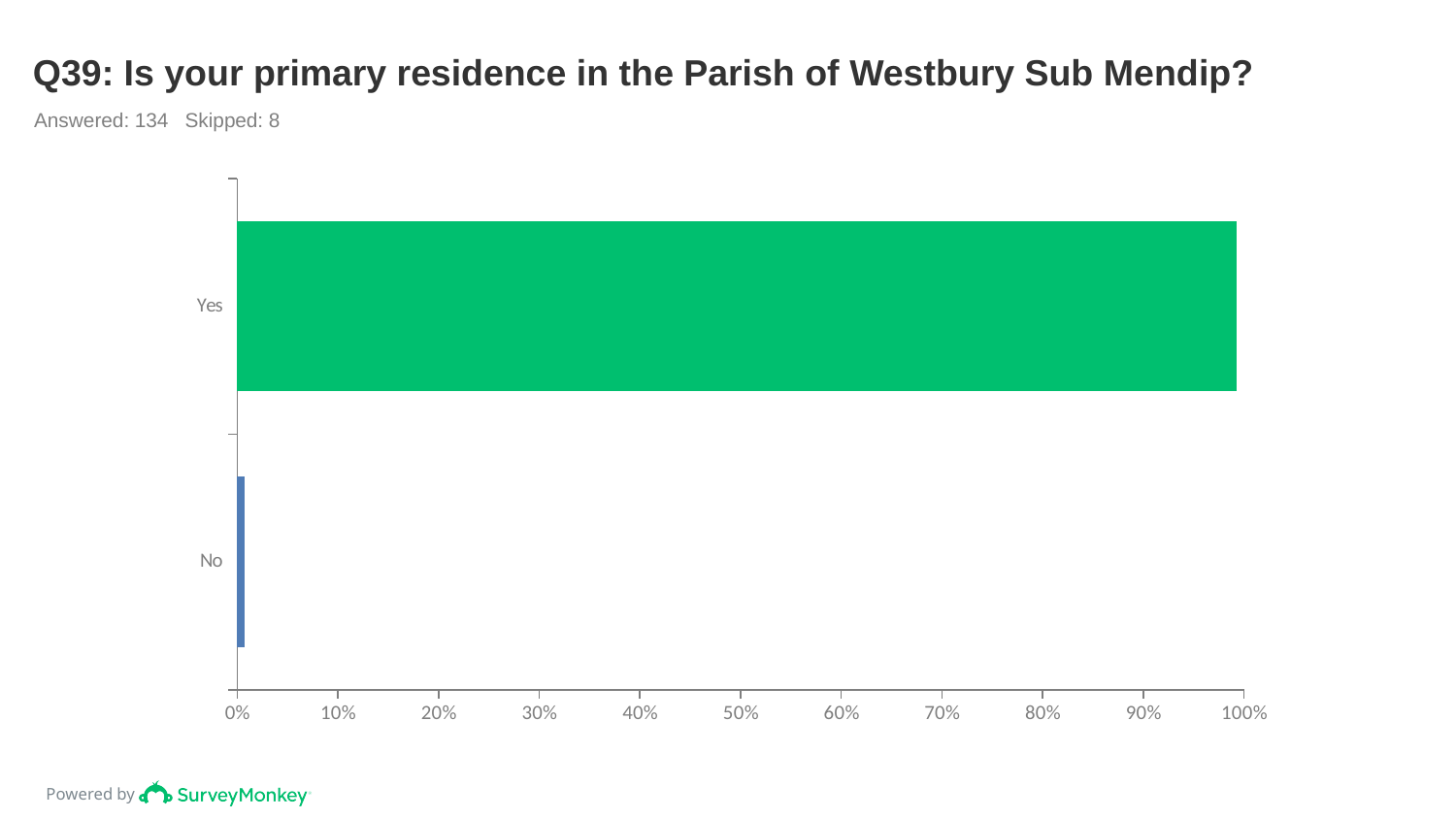
Is the value for Yes greater or less than 50%? greater Is the value for No greater or less than 10%? less How many respondents answered the question according to the slide? 134 Which is larger, the value for Yes or the value for No? Yes How many categories are plotted in the chart? 2 What is the title of the chart? Q39: Is your primary residence in the Parish of Westbury Sub Mendip? What kind of chart is shown on the slide? bar chart Is the value for Yes greater or less than 90%? greater Which category has the highest value? Yes Which category has the lowest value? No